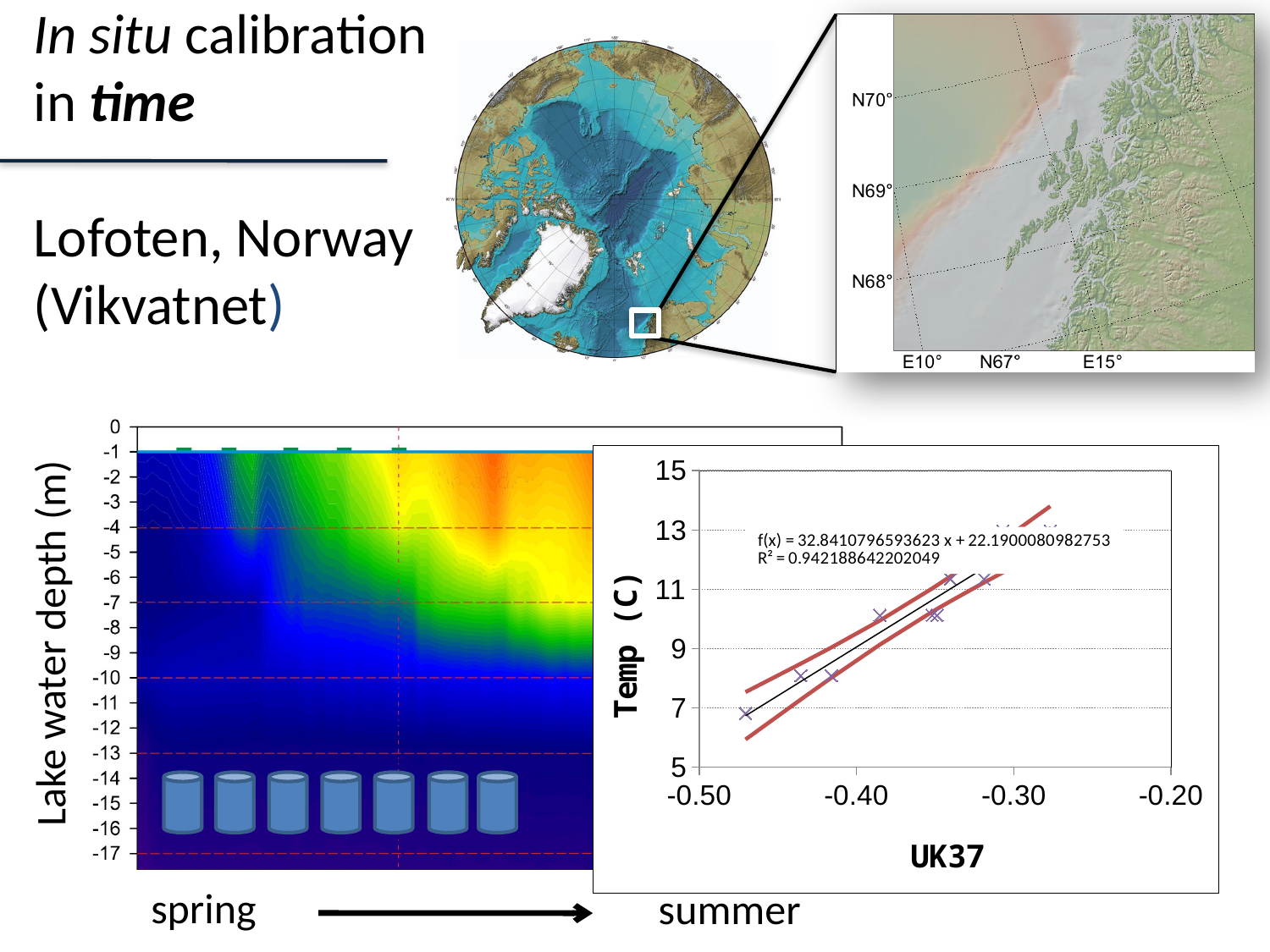
In the Temp vs UK37 scatter chart, what is the R² value printed on the chart? 0.942188642202049 In the Temp vs UK37 scatter chart, what is the slope of the fitted line f(x) shown on the chart? 32.8410796593623 In the Temp vs UK37 scatter chart, is the temperature of the leftmost data point (near UK37 = -0.47) greater or less than 9? less In the Temp vs UK37 scatter chart, do the temperature values rise or fall as UK37 increases along the x axis? rise In the Temp vs UK37 scatter chart, is the temperature of the data point near UK37 = -0.44 greater or less than 9? less What kind of chart is the Temp vs UK37 chart on the lower right of the slide? scatter chart In the Temp vs UK37 scatter chart, what is the intercept of the fitted line f(x) shown on the chart? 22.1900080982753 What is the label of the x axis of the scatter chart on the lower right of the slide? UK37 What is the label of the y axis of the scatter chart on the lower right of the slide? Temp (C) In the Temp vs UK37 scatter chart, is the temperature of the data point near UK37 = -0.39 greater or less than 9? greater In the Temp vs UK37 scatter chart, which has the higher temperature: the leftmost data point (near UK37 = -0.47) or the rightmost data point (near UK37 = -0.32)? the rightmost data point (near UK37 = -0.32)